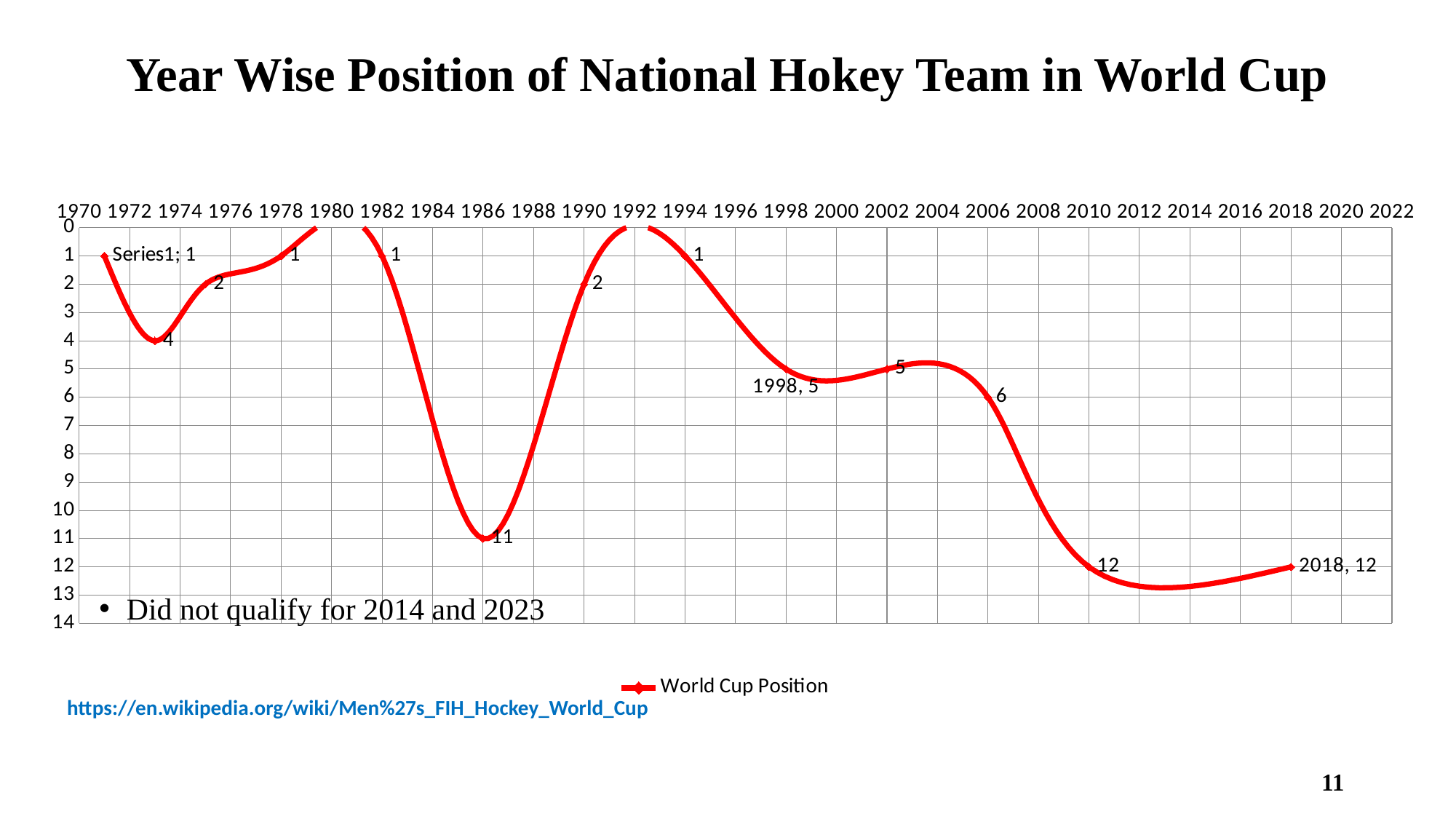
What is the name of the series shown in the legend? World Cup Position What kind of chart is shown on the slide? line chart What is the World Cup position plotted for 1998? 5 What is the World Cup position plotted for 2018? 12 How many series does the legend list? 1 What is the World Cup position plotted for 1986? 11 What is the World Cup position plotted for 2010? 12 What is the lowest value plotted on the chart? 1 How many data points are plotted on the line? 13 What is the difference between the plotted values for 2018 and 1998? 7 What is the World Cup position plotted for 2006? 6 Which has the larger plotted value, 1998 or 2018? 2018